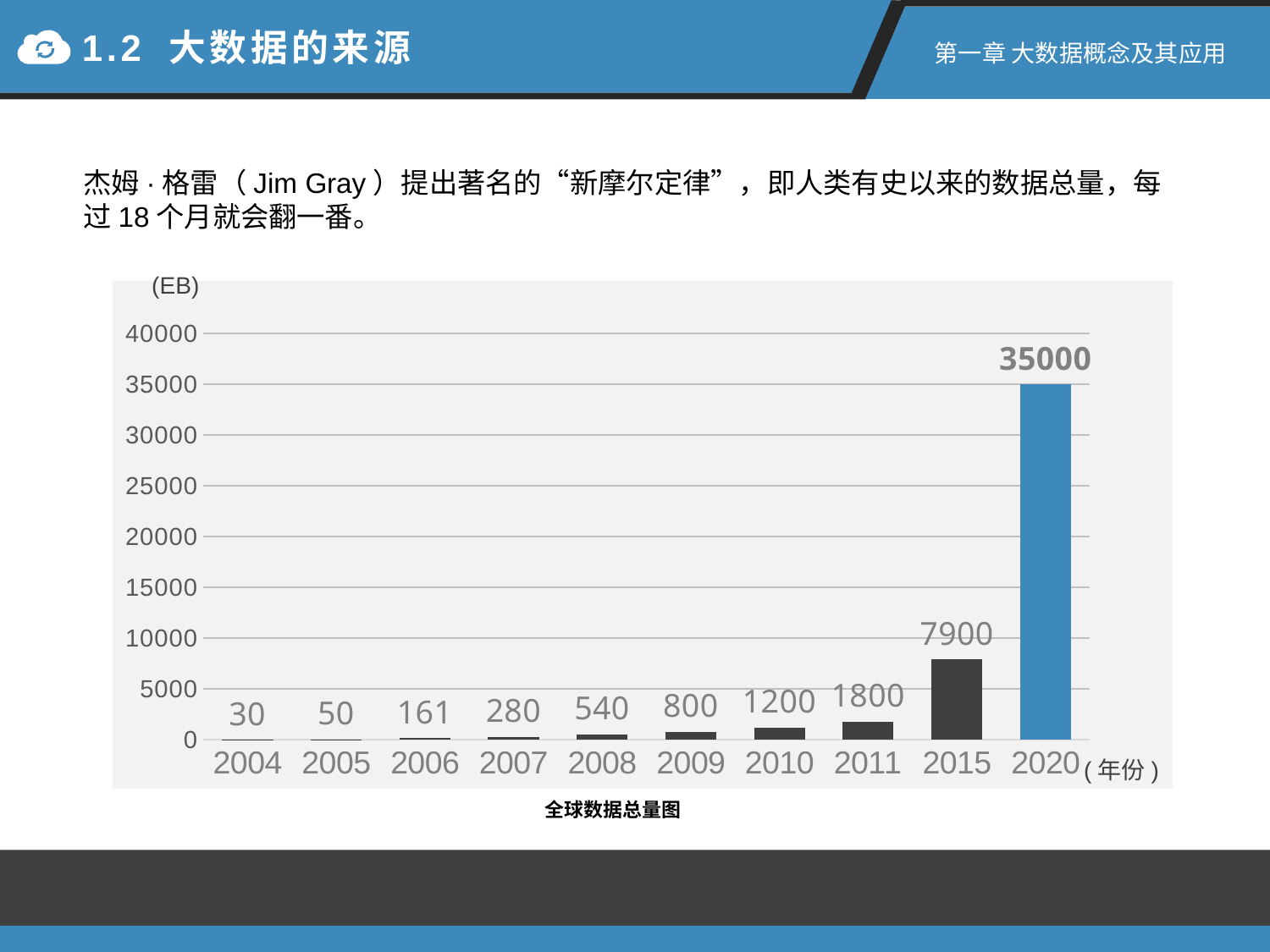
Which is larger, the value for 2009 or the value for 2007? 2009 What is the value for 2004? 30 Which year has the highest value? 2020 What is the value for 2020? 35000 What is the difference between the values for 2020 and 2015? 27100 Do the values rise or fall from 2004 to 2020? rise How many years are shown on the x axis? 10 What kind of chart is this? bar chart Which year has the lowest value? 2004 What is the value for 2015? 7900 What is the value for 2008? 540 What is the difference between the values for 2011 and 2010? 600